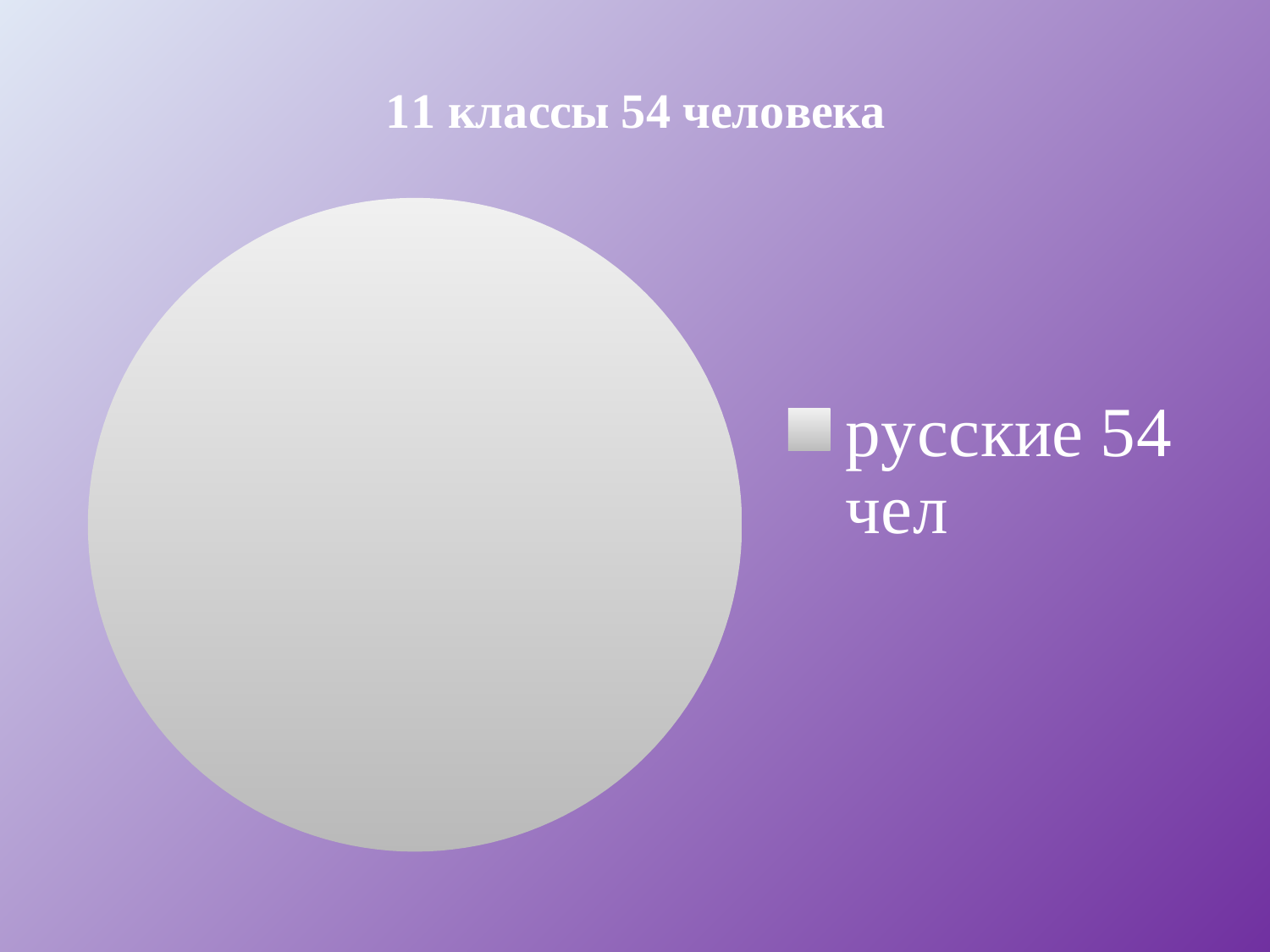
What kind of chart is shown on the slide? pie chart How many people does the legend give for русские? 54 чел What is the title of the chart? 11 классы 54 человека How many entries does the legend list? 1 What share of the pie does the slice for русские take up? 100% What is the legend entry for the pie chart? русские 54 чел How many people in total does the chart title say are in the 11th classes? 54 человека How many slices does the pie chart have? 1